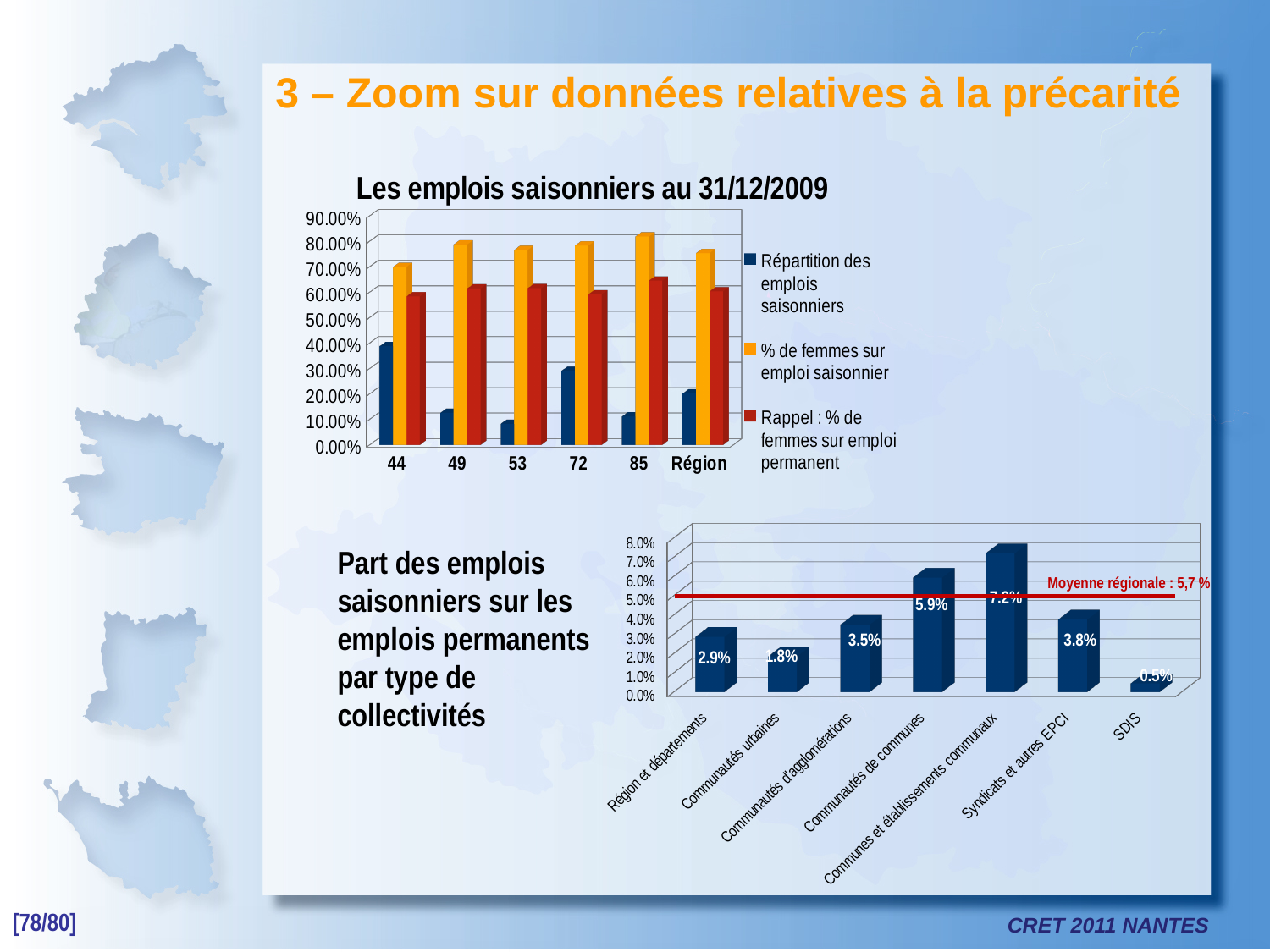
In the bottom chart, which type of collectivité has the lowest share of seasonal jobs? SDIS In the top chart, which category has the highest value for 'Répartition des emplois saisonniers'? 44 In the bottom chart, which type of collectivité has the highest share of seasonal jobs? Communes et établissements communaux In the bottom chart, what is the value for SDIS? 0.5% In the bottom chart, what is the value for Syndicats et autres EPCI? 3.8% How many categories are shown on the x axis of the top chart (Les emplois saisonniers au 31/12/2009)? 6 In the top chart, is the value of 'Répartition des emplois saisonniers' for 53 greater or less than 10.00%? less In the bottom chart, which is larger: the value for Communautés urbaines or the value for Communautés d'agglomérations? Communautés d'agglomérations In the bottom chart, what is the difference between the values for Communes et établissements communaux and Région et départements? 4.3% In the bottom chart (Part des emplois saisonniers sur les emplois permanents par type de collectivités), what is the value for Communautés de communes? 5.9% How many series does the legend of the top chart list? 3 In the bottom chart, what regional average (Moyenne régionale) is indicated by the red line? 5,7 %